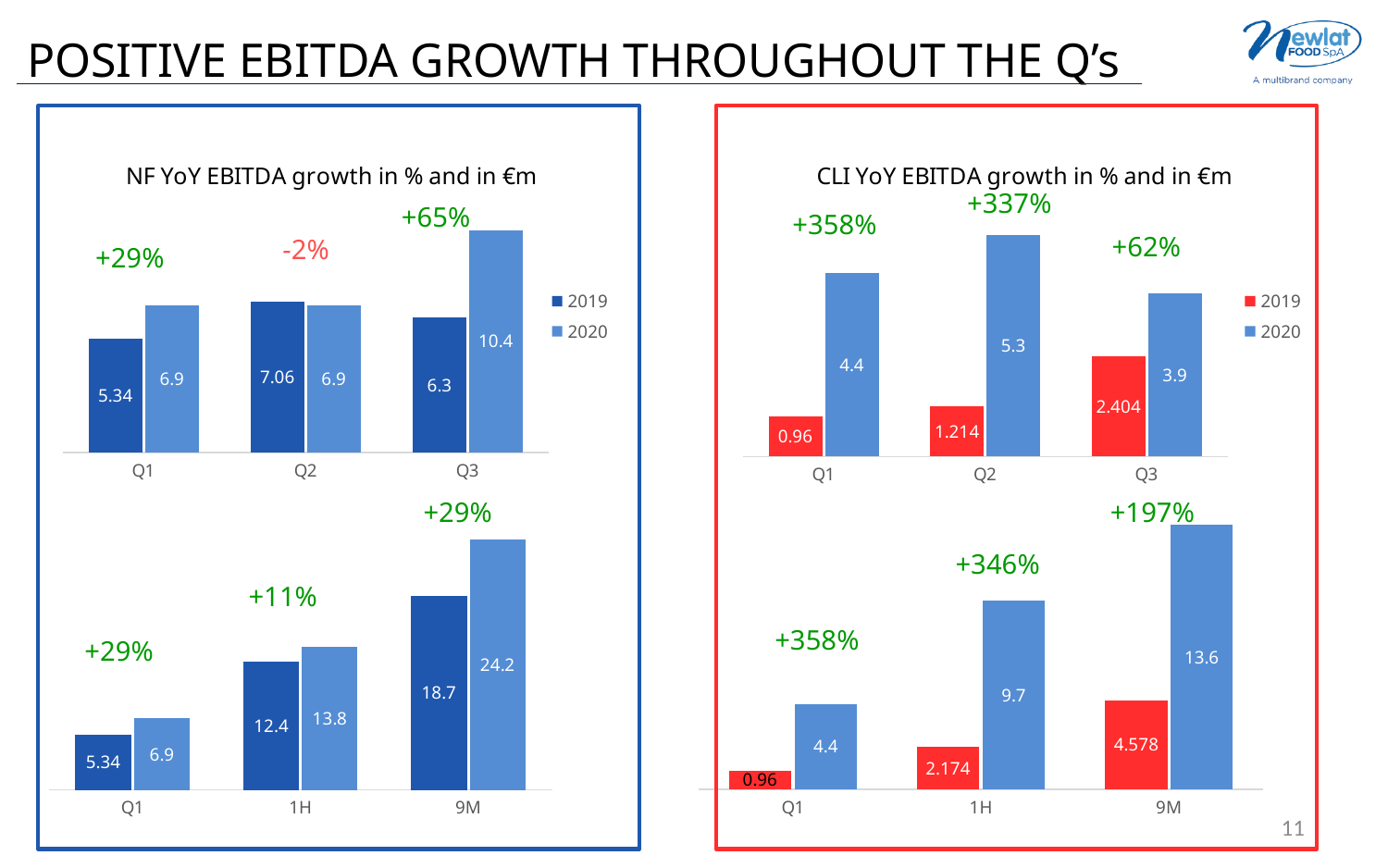
How many series does the legend of the top-right chart (CLI YoY EBITDA growth) list? 2 In the bottom-right chart (CLI, Q1/1H/9M), which is larger, the 2019 value for 9M or the 2020 value for Q1? 2019 value for 9M In the top-left chart (NF YoY EBITDA growth, quarterly), what is the 2019 value for Q2? 7.06 In the top-left chart (NF YoY EBITDA growth, quarterly), what is the difference between the 2020 and 2019 values for Q3? 4.1 In the top-right chart (CLI YoY EBITDA growth, quarterly), which quarter has the highest 2020 value? Q2 In the top-left chart (NF YoY EBITDA growth, quarterly), what is the 2020 value for Q3? 10.4 In the bottom-right chart (CLI, Q1/1H/9M), what is the 2020 value for 1H? 9.7 In the top-right chart (CLI YoY EBITDA growth, quarterly), what is the 2019 value for Q3? 2.404 In the bottom-left chart (NF, Q1/1H/9M), what is the 2020 value for 9M? 24.2 In the top-right chart (CLI YoY EBITDA growth, quarterly), what YoY growth percentage is shown above Q1? +358% In the bottom-left chart (NF, Q1/1H/9M), which category has the highest 2019 value? 9M In the top-left chart (NF YoY EBITDA growth, quarterly), what YoY growth percentage is shown above Q2? -2%